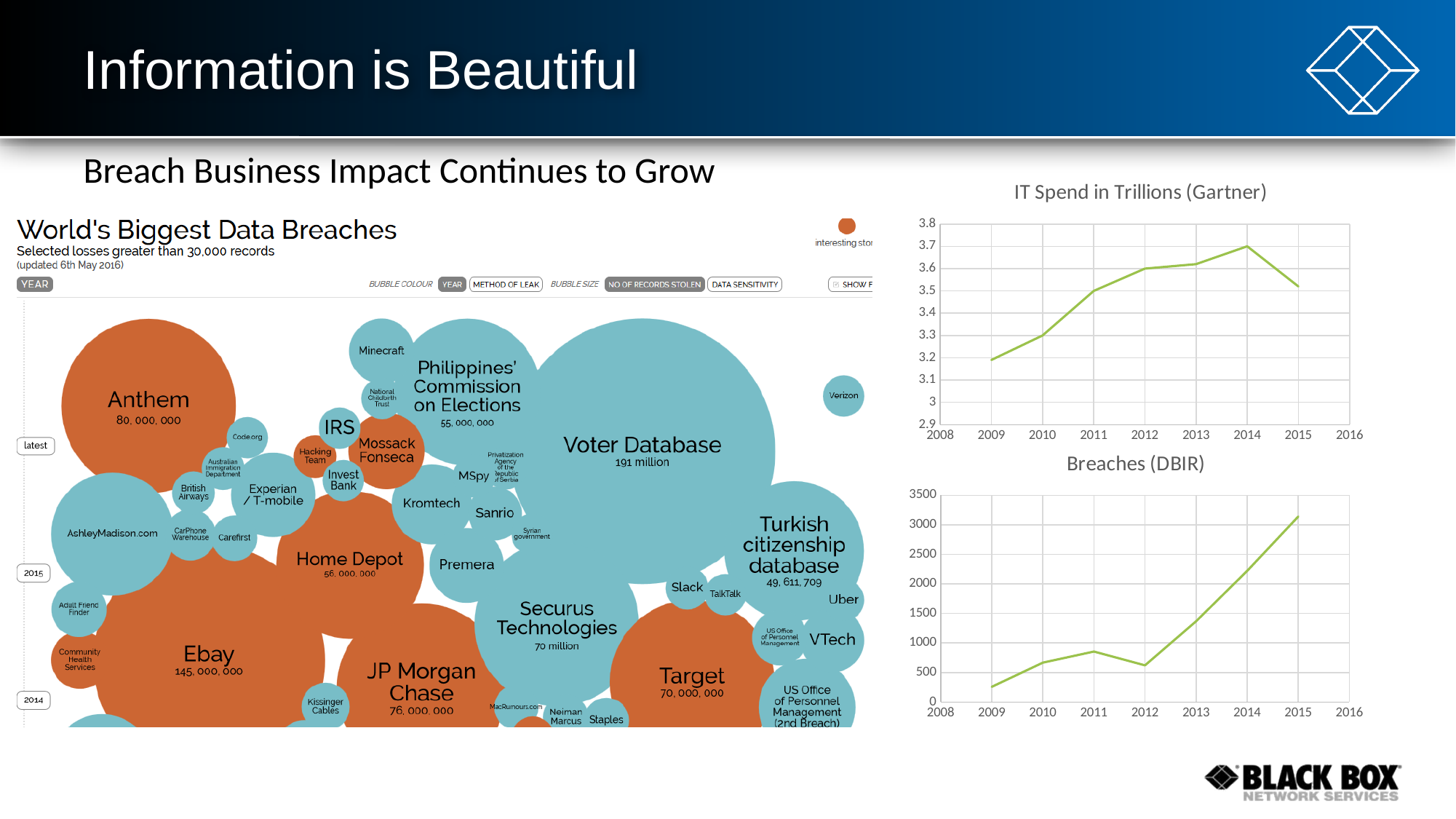
In the 'Breaches (DBIR)' chart, which year has the highest value? 2015 In the 'IT Spend in Trillions (Gartner)' chart, which year has the highest value? 2014 In the 'Breaches (DBIR)' chart, which is larger, the value for 2011 or the value for 2012? 2011 In the 'Breaches (DBIR)' chart, do the values generally rise or fall from 2012 to 2015? rise In the 'IT Spend in Trillions (Gartner)' chart, is the value for 2015 greater or less than 3.6? less In the 'World's Biggest Data Breaches' bubble chart, how many records are shown for the Turkish citizenship database? 49,611,709 In the 'Breaches (DBIR)' chart, is the value for 2015 greater or less than 3000? greater In the 'World's Biggest Data Breaches' bubble chart, how many records are shown for Ebay? 145,000,000 What kind of chart is the 'IT Spend in Trillions (Gartner)' chart? line chart In the 'IT Spend in Trillions (Gartner)' chart, which year has the lowest value? 2009 In the 'IT Spend in Trillions (Gartner)' chart, is the value for 2011 greater or less than 3.4? greater